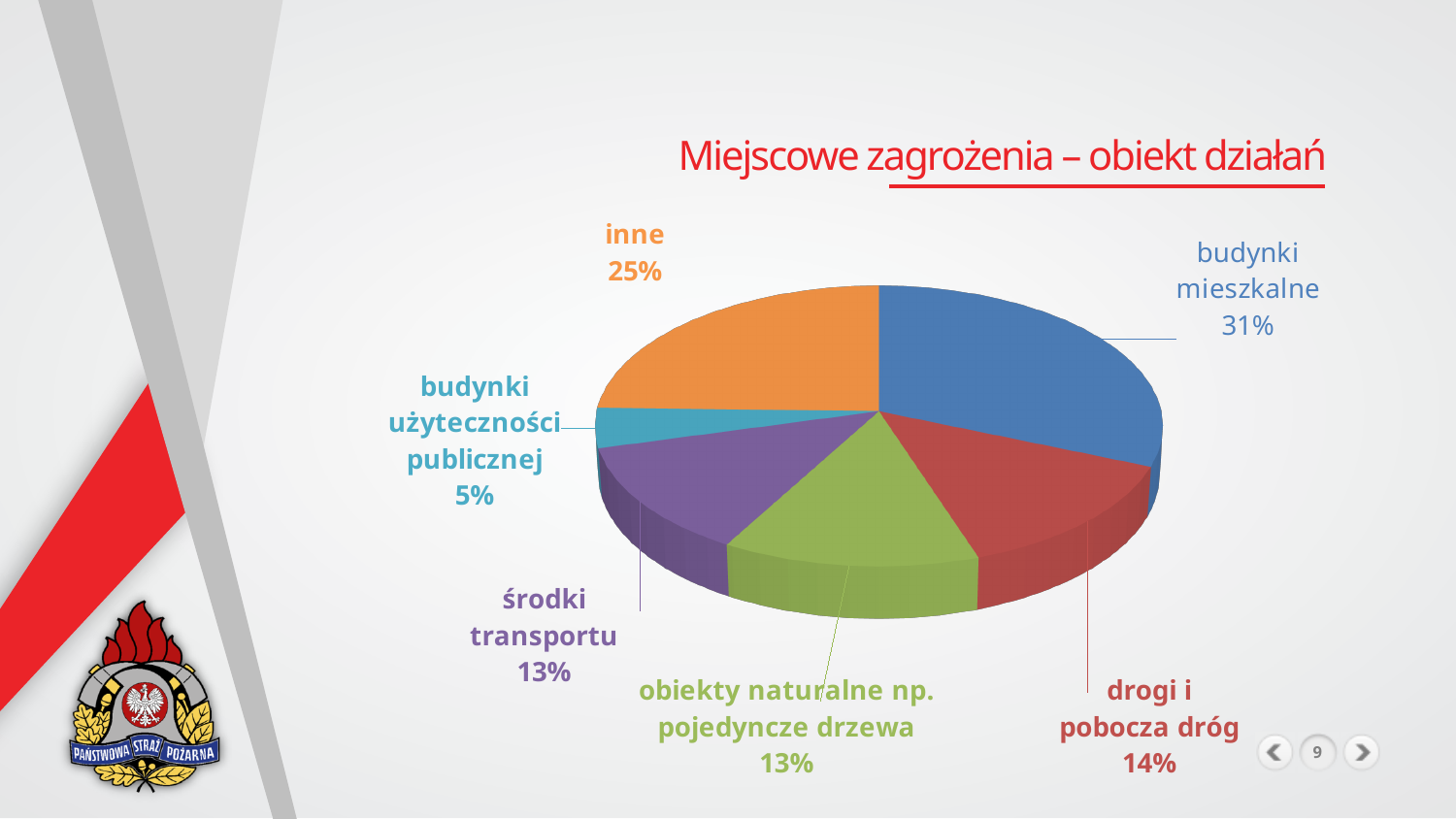
How many slices does the pie chart have? 6 What type of chart is shown on the slide? pie chart Which category has the smallest share of the pie? budynki użyteczności publicznej What percentage is shown for "budynki użyteczności publicznej"? 5% What is the title of the chart? Miejscowe zagrożenia – obiekt działań What is the difference in percentage points between "budynki mieszkalne" and "inne"? 6 What percentage is shown for "inne"? 25% Which is larger, the share for "drogi i pobocza dróg" or the share for "budynki użyteczności publicznej"? drogi i pobocza dróg What percentage is shown for "drogi i pobocza dróg"? 14% What share of the pie is labelled "budynki mieszkalne"? 31% Which category has the largest share of the pie? budynki mieszkalne What percentage is shown for "środki transportu"? 13%